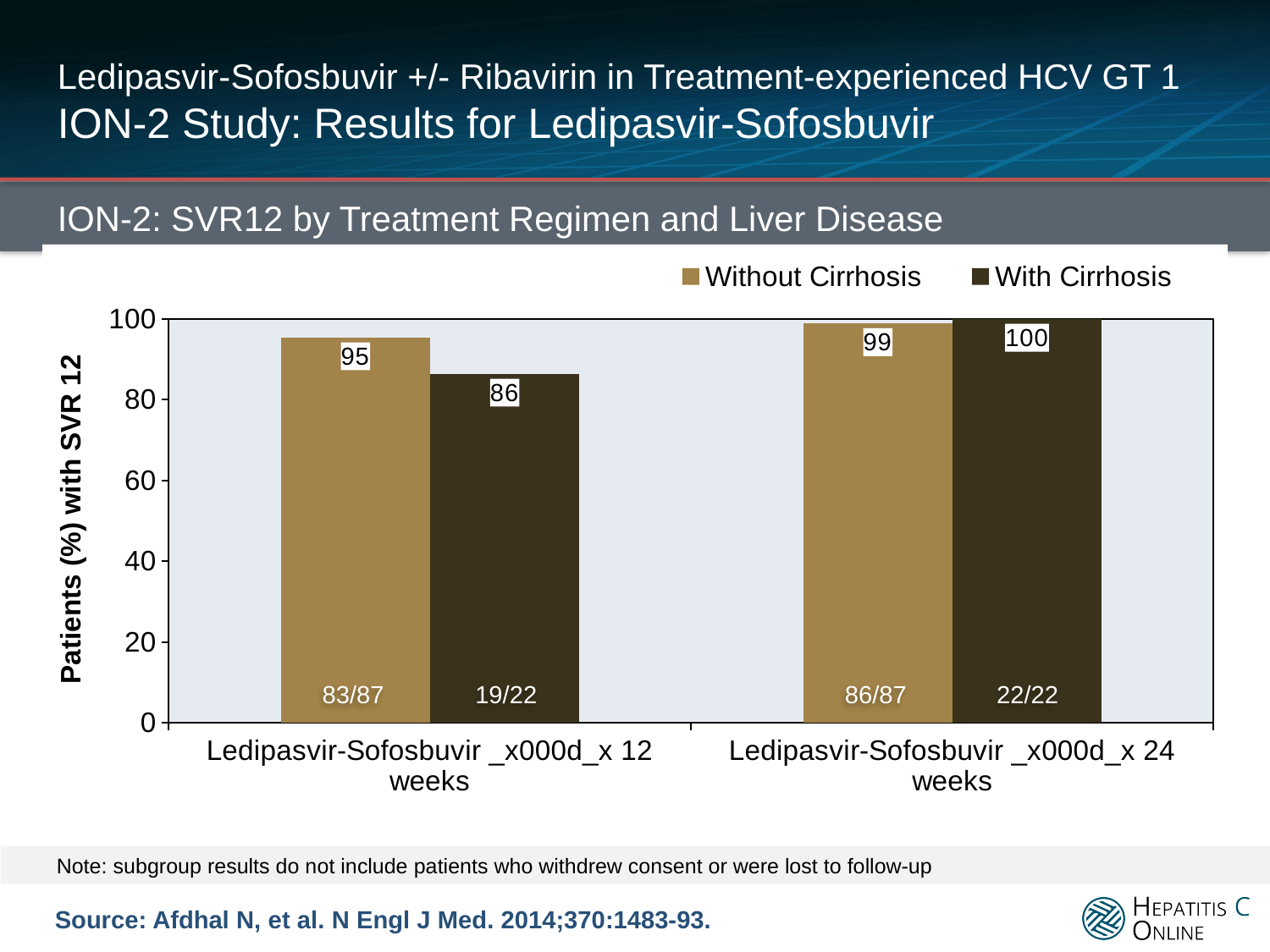
Which bar shows the highest SVR12 rate? With Cirrhosis, Ledipasvir-Sofosbuvir x 24 weeks Which bar shows the lowest SVR12 rate? With Cirrhosis, Ledipasvir-Sofosbuvir x 12 weeks What is the SVR12 rate for patients with cirrhosis treated with Ledipasvir-Sofosbuvir for 24 weeks? 100 In the 12-week group, which has the higher SVR12 rate: patients without cirrhosis or with cirrhosis? Without Cirrhosis How many series does the legend list? 2 What is the difference in SVR12 rate between patients without cirrhosis and with cirrhosis in the 12-week group? 9 What is the label of the y-axis? Patients (%) with SVR 12 What fraction of patients is shown inside the bar for patients with cirrhosis treated for 12 weeks? 19/22 What is the SVR12 rate for patients without cirrhosis treated with Ledipasvir-Sofosbuvir for 24 weeks? 99 What is the SVR12 rate for patients with cirrhosis treated with Ledipasvir-Sofosbuvir for 12 weeks? 86 What is the SVR12 rate for patients without cirrhosis treated with Ledipasvir-Sofosbuvir for 12 weeks? 95 What kind of chart is shown on the slide? Bar chart